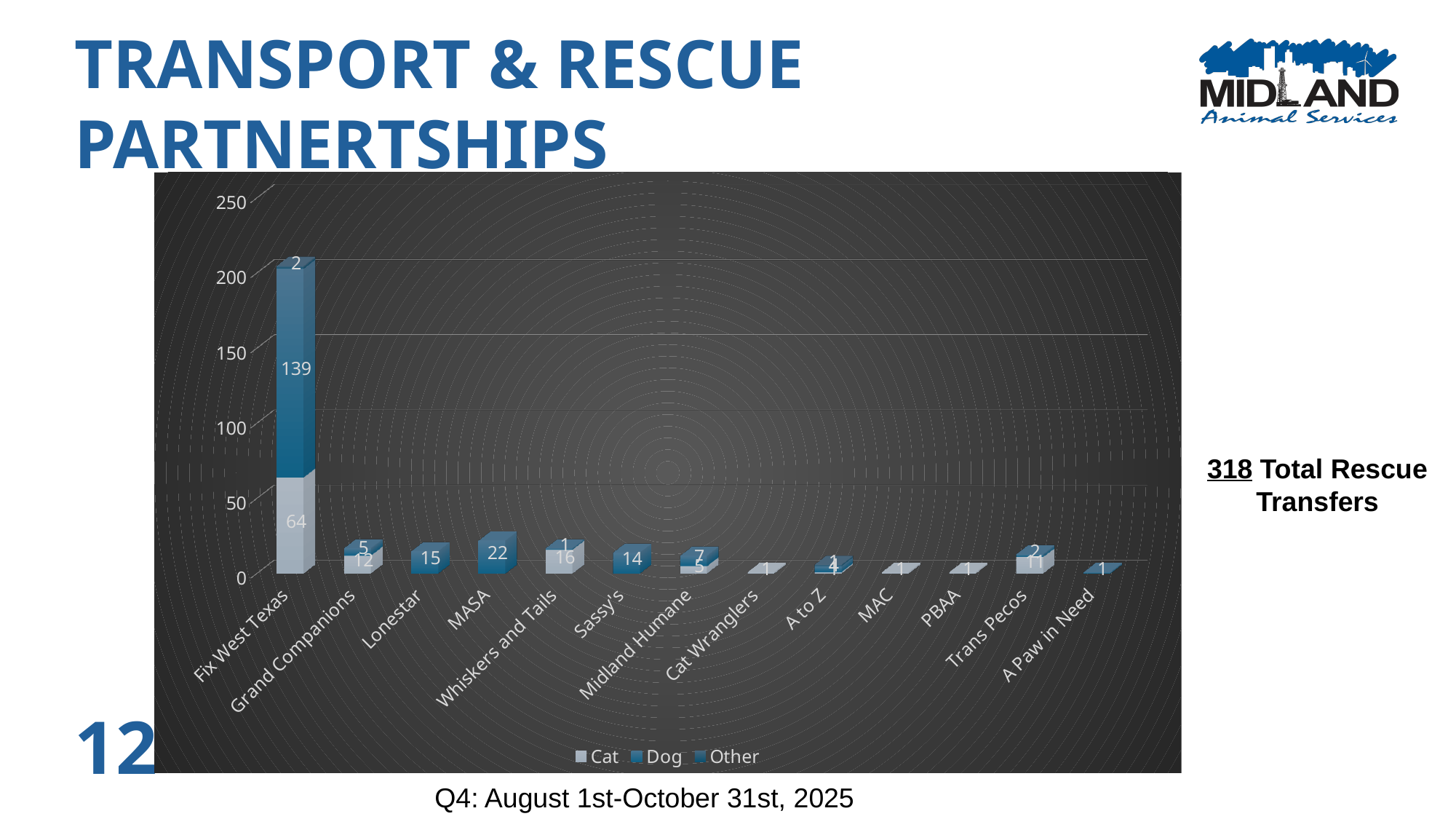
How many Dog transfers are shown for Fix West Texas? 139 How many series does the legend list? 3 Which is larger, the Dog value for MASA or the Dog value for Sassy's? MASA What kind of chart is shown on the slide? Stacked bar chart What is the difference between the Dog value for MASA and the Dog value for Lonestar? 7 What is the Cat value for Grand Companions? 12 What is the total of the stacked bar for Fix West Texas (Cat, Dog and Other)? 205 Which partner has the tallest stacked bar? Fix West Texas How many Cat transfers are shown for Fix West Texas? 64 Is the total stacked value for Fix West Texas greater or less than 200? greater What is the Dog value for MASA? 22 How many partner organizations are listed on the x axis? 13